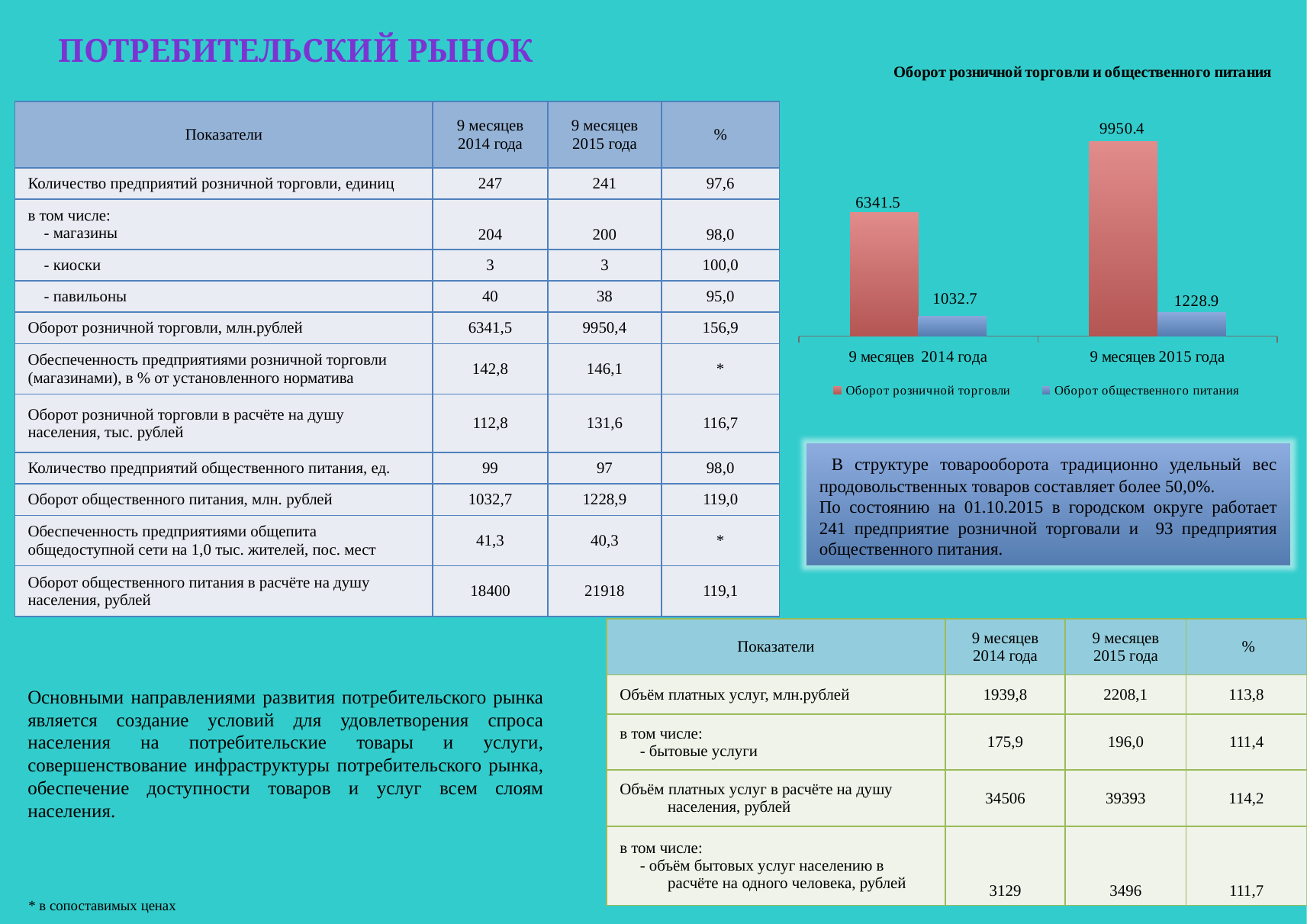
Does Оборот розничной торговли rise or fall from 9 месяцев 2014 года to 9 месяцев 2015 года? rise What is the title of the chart? Оборот розничной торговли и общественного питания What type of chart is shown on the slide? bar chart What is the value of Оборот общественного питания for 9 месяцев 2015 года? 1228.9 By how much did Оборот розничной торговли increase from 9 месяцев 2014 года to 9 месяцев 2015 года? 3608.9 What is the value of Оборот розничной торговли for 9 месяцев 2015 года? 9950.4 How many series does the chart legend list? 2 What is the value of Оборот общественного питания for 9 месяцев 2014 года? 1032.7 What is the value of Оборот розничной торговли for 9 месяцев 2014 года? 6341.5 Which series has the higher value for 9 месяцев 2015 года, Оборот розничной торговли or Оборот общественного питания? Оборот розничной торговли What is the difference between Оборот общественного питания for 9 месяцев 2015 года and 9 месяцев 2014 года? 196.2 How many categories are shown on the x axis of the chart? 2